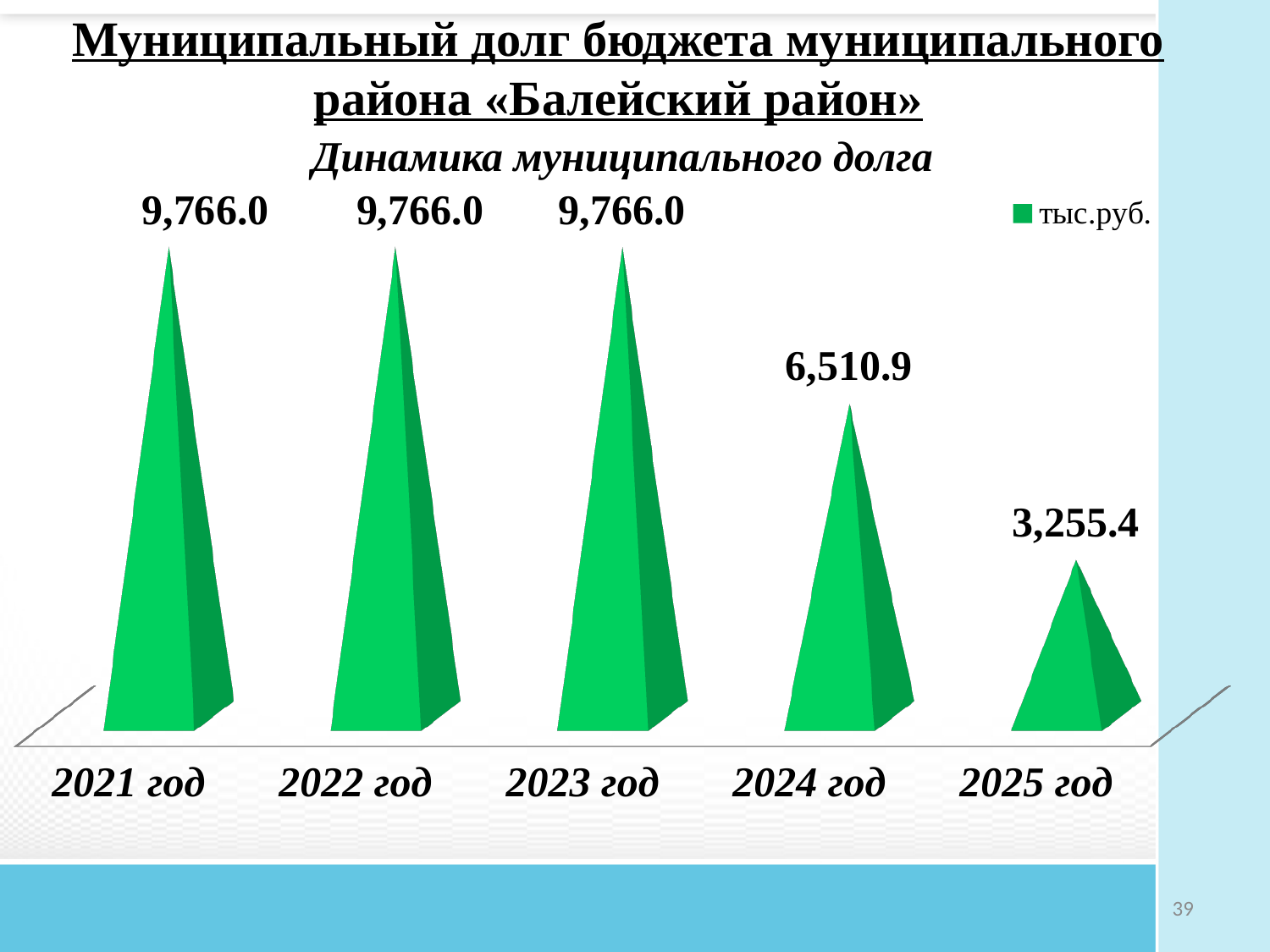
How many years are shown on the x axis? 5 What is the value for 2025 год? 3,255.4 What is the difference between the values for 2024 год and 2025 год? 3,255.5 What is the value for 2021 год? 9,766.0 What is the difference between the values for 2023 год and 2024 год? 3,255.1 What is the value for 2024 год? 6,510.9 What unit is given in the legend? тыс.руб. Which is larger, the value for 2022 год or the value for 2025 год? 2022 год Which year has the lowest value? 2025 год What kind of chart is shown? bar chart How many series does the legend list? 1 Do the values rise or fall from 2023 год to 2025 год? fall